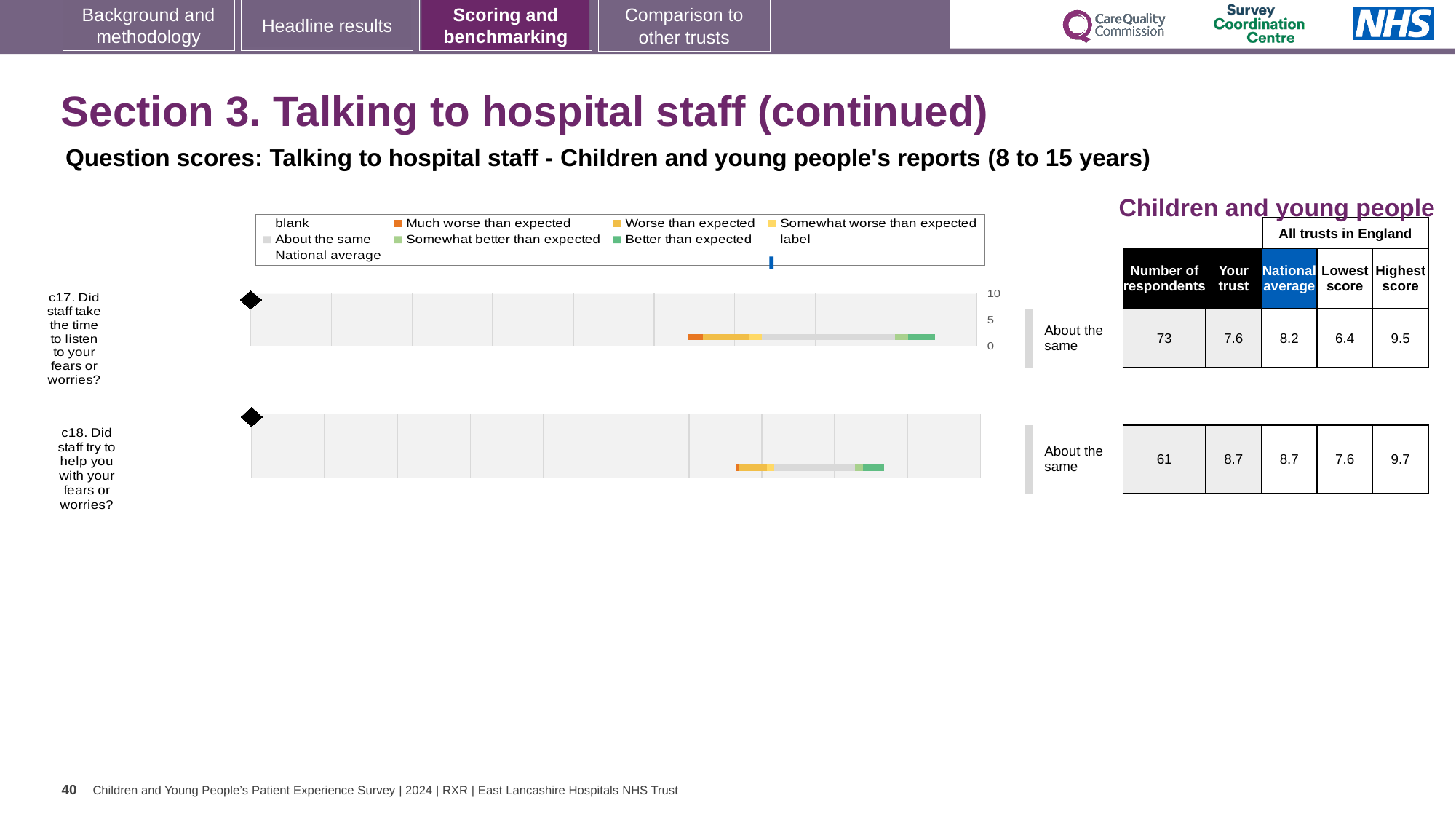
How many questions are plotted on the slide? 2 What is the highest score among all trusts in England for question c18? 9.7 What is the difference between the national average and the trust's score for question c17? 0.6 What is the difference between the highest and lowest scores across all trusts in England for question c18? 2.1 What is the 'Your trust' score for question c17 (Did staff take the time to listen to your fears or worries?)? 7.6 Which question has the higher 'Your trust' score, c17 or c18? c18 What is the benchmark category shown for question c18? About the same What is the lowest score among all trusts in England for question c17? 6.4 What is the national average score for question c18 (Did staff try to help you with your fears or worries?)? 8.7 What is the maximum value shown on the chart's scale axis? 10 Which question has more respondents, c17 or c18? c17 How many respondents answered question c17? 73